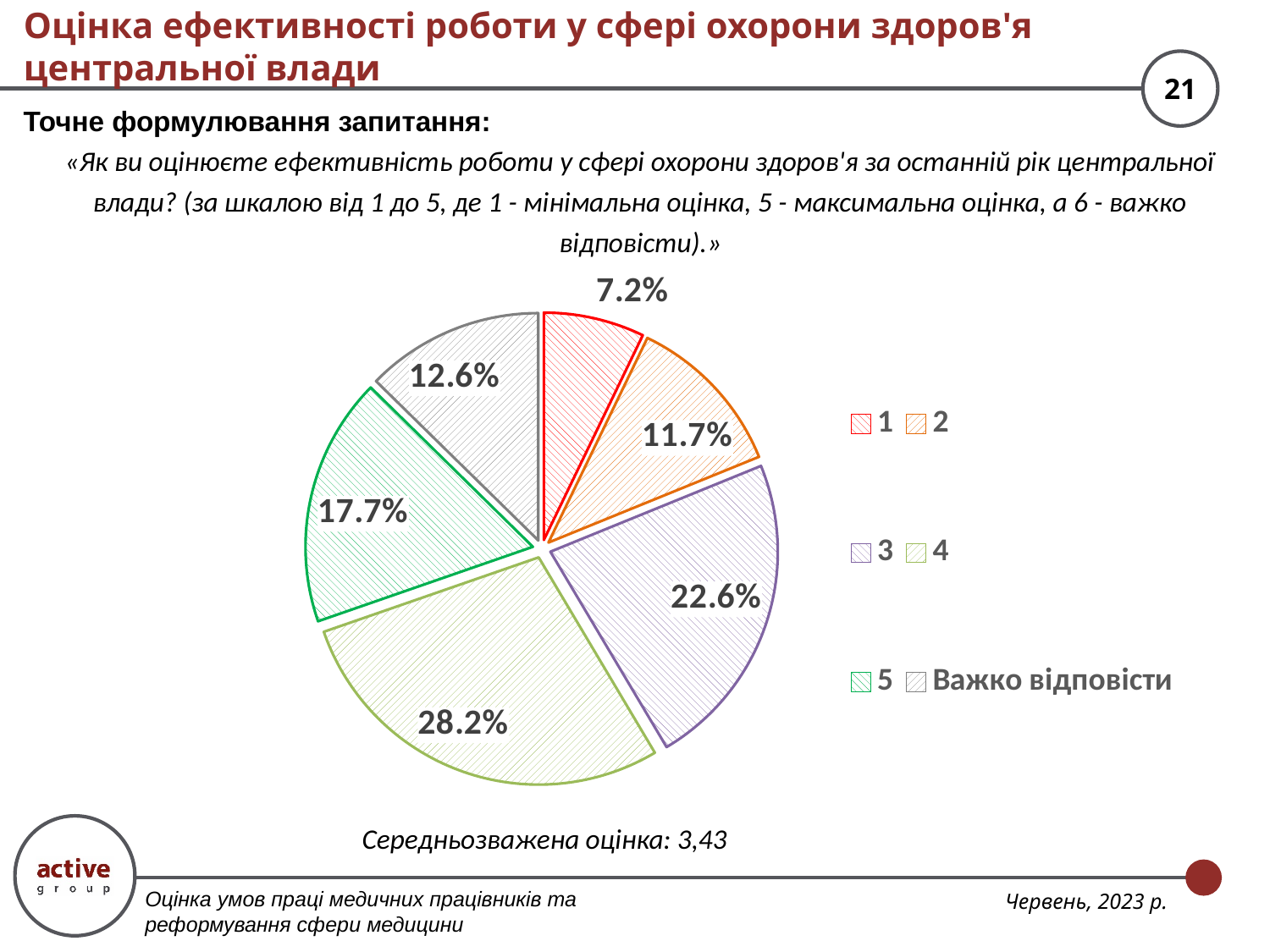
How many entries does the legend list? 6 What is the difference in percentage points between the slices for rating 4 and rating 3? 5.6 How many slices does the pie chart have? 6 Which rating category has the largest slice of the pie? 4 What share of respondents gave a rating of 1? 7.2% Which slice is larger: rating 5 or rating 2? 5 What share of respondents answered "Важко відповісти"? 12.6% What kind of chart is shown on the slide? pie chart What share of respondents gave a rating of 4? 28.2% Which category has the smallest slice of the pie? 1 What weighted average score is stated below the chart? 3,43 What share of respondents gave a rating of 3? 22.6%